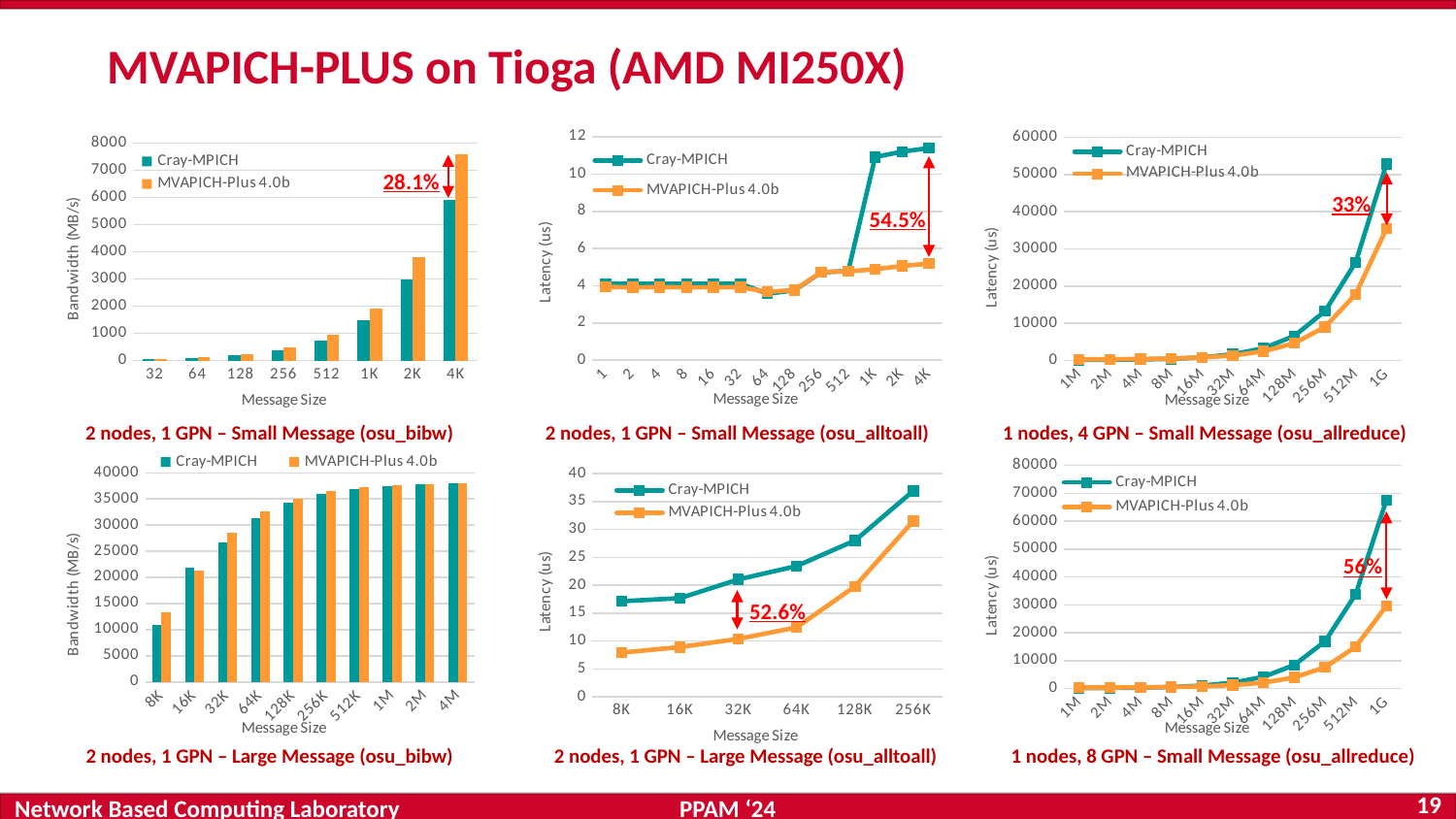
In the '2 nodes, 1 GPN – Small Message (osu_bibw)' chart, is the Cray-MPICH bandwidth at 4K greater or less than 5000? greater In the '2 nodes, 1 GPN – Large Message (osu_alltoall)' chart, how many message sizes are shown on the x axis? 6 How many series does the legend list in the '1 nodes, 4 GPN – Small Message (osu_allreduce)' chart? 2 What kind of chart is the '2 nodes, 1 GPN – Small Message (osu_alltoall)' chart at the top middle? line chart What percentage improvement is annotated on the '1 nodes, 4 GPN – Small Message (osu_allreduce)' chart? 33% What kind of chart is the '2 nodes, 1 GPN – Small Message (osu_bibw)' chart at the top left? bar chart In the '2 nodes, 1 GPN – Small Message (osu_bibw)' chart, how many message sizes are shown on the x axis? 8 In the '2 nodes, 1 GPN – Large Message (osu_alltoall)' chart, does the Cray-MPICH latency rise or fall as message size increases? rises In the '2 nodes, 1 GPN – Large Message (osu_bibw)' chart, is the MVAPICH-Plus 4.0b bandwidth at 8K greater or less than 10000? greater In the '1 nodes, 8 GPN – Small Message (osu_allreduce)' chart, is the Cray-MPICH latency at 1G greater or less than 60000? greater In the '2 nodes, 1 GPN – Large Message (osu_alltoall)' chart, which series has the higher latency at 256K? Cray-MPICH In the '2 nodes, 1 GPN – Small Message (osu_bibw)' chart, which message size has the highest Cray-MPICH bandwidth? 4K